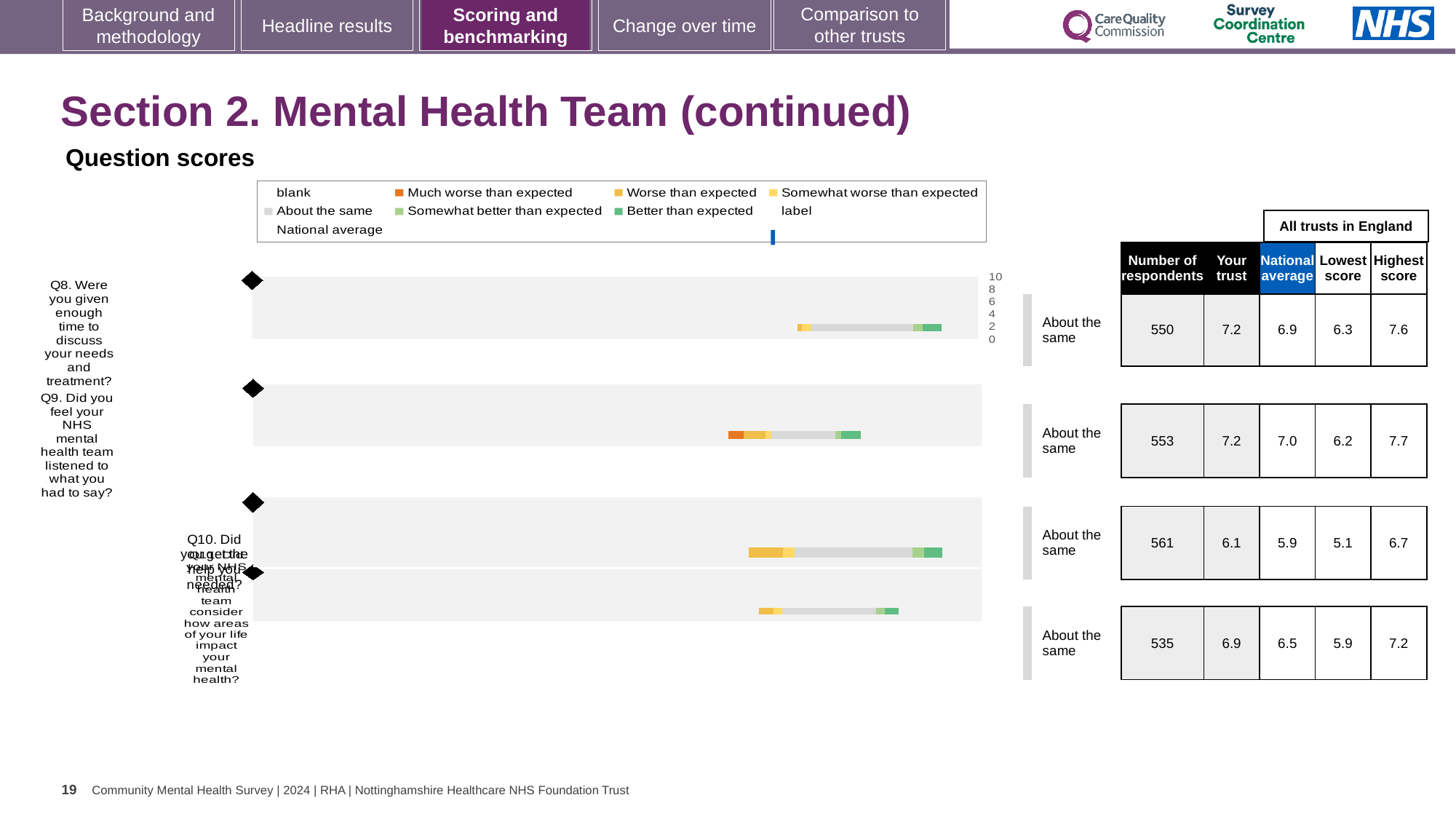
In the table next to the chart, what is the national average for Q9 (Did you feel your NHS mental health team listened to what you had to say)? 7.0 In the table next to the chart, how many respondents answered Q10 (Did you get the help you needed)? 561 What kind of chart is used to show the question scores on this slide? bar chart What is the difference between the 'Your trust' score and the national average for Q10 in the table? 0.2 In the table next to the chart, what is the 'Your trust' score for Q8 (Were you given enough time to discuss your needs and treatment)? 7.2 Is the 'Your trust' score for Q8 larger or smaller than the national average for Q8 in the table? larger In the table next to the chart, what is the lowest score across all trusts in England for Q10? 5.1 What colour does the legend use for 'Much worse than expected'? orange In the table next to the chart, what is the highest score across all trusts in England for Q9? 7.7 Which question has the lowest 'Your trust' score in the table next to the chart? Q10 What benchmark category is shown beside the bar for Q9? About the same How many questions (bars) are plotted in the question scores chart? 4